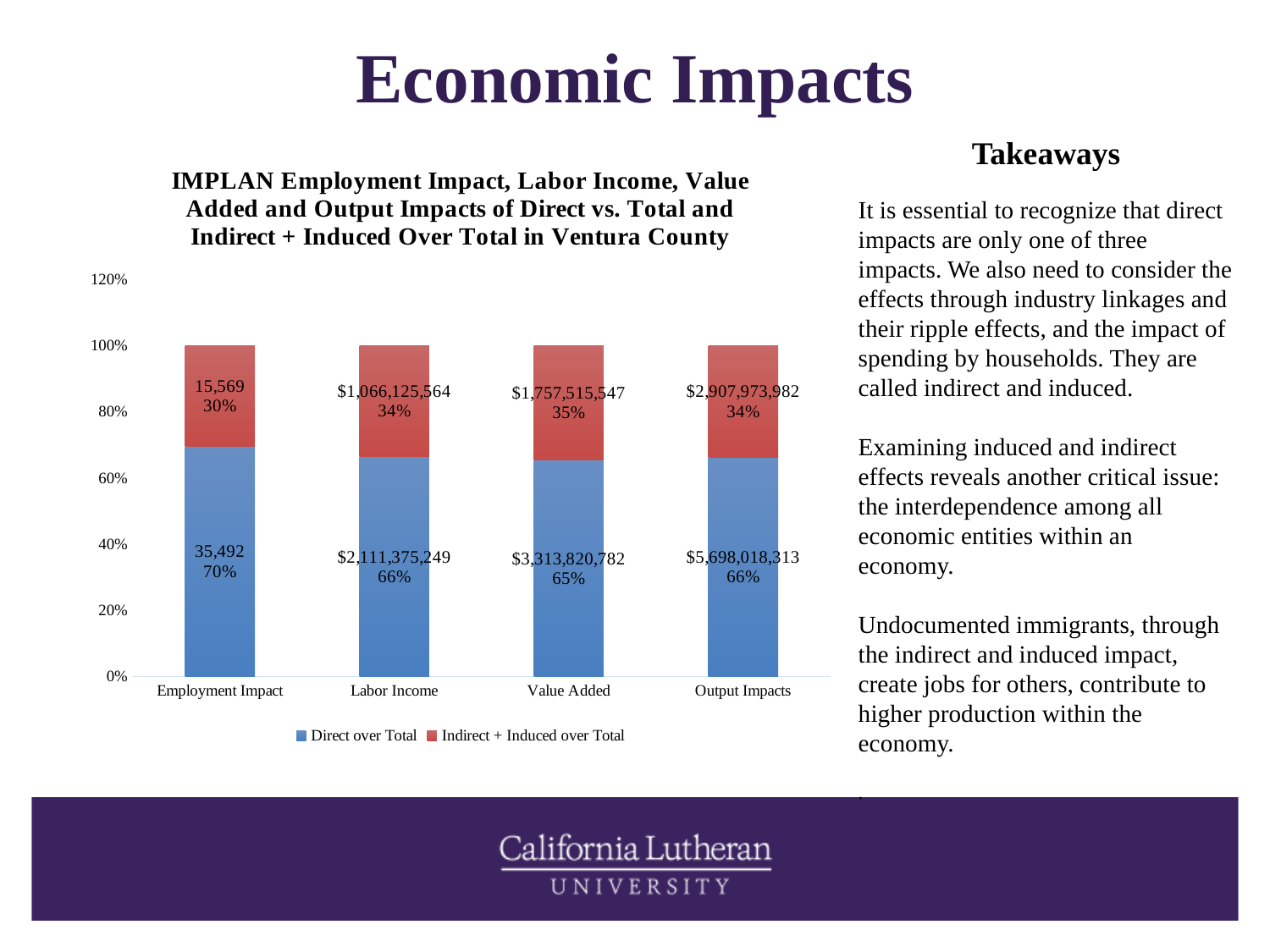
What is the Direct over Total percentage for Employment Impact? 70% Which is larger: the Indirect + Induced over Total share for Employment Impact or for Output Impacts? Output Impacts What is the Direct over Total employment figure shown for Employment Impact? 35,492 What is the Indirect + Induced over Total percentage for Value Added? 35% What is the difference in percentage points between the Direct over Total and Indirect + Induced over Total shares for Employment Impact? 40 percentage points How many categories are shown on the x axis of the chart? 4 Which category has the highest Direct over Total percentage? Employment Impact What is the Indirect + Induced over Total dollar value shown for Output Impacts? $2,907,973,982 Which category has the lowest Indirect + Induced over Total percentage? Employment Impact How many series does the chart legend list? 2 What type of chart is shown on the slide? Stacked bar chart What is the Direct over Total dollar value shown for Labor Income? $2,111,375,249